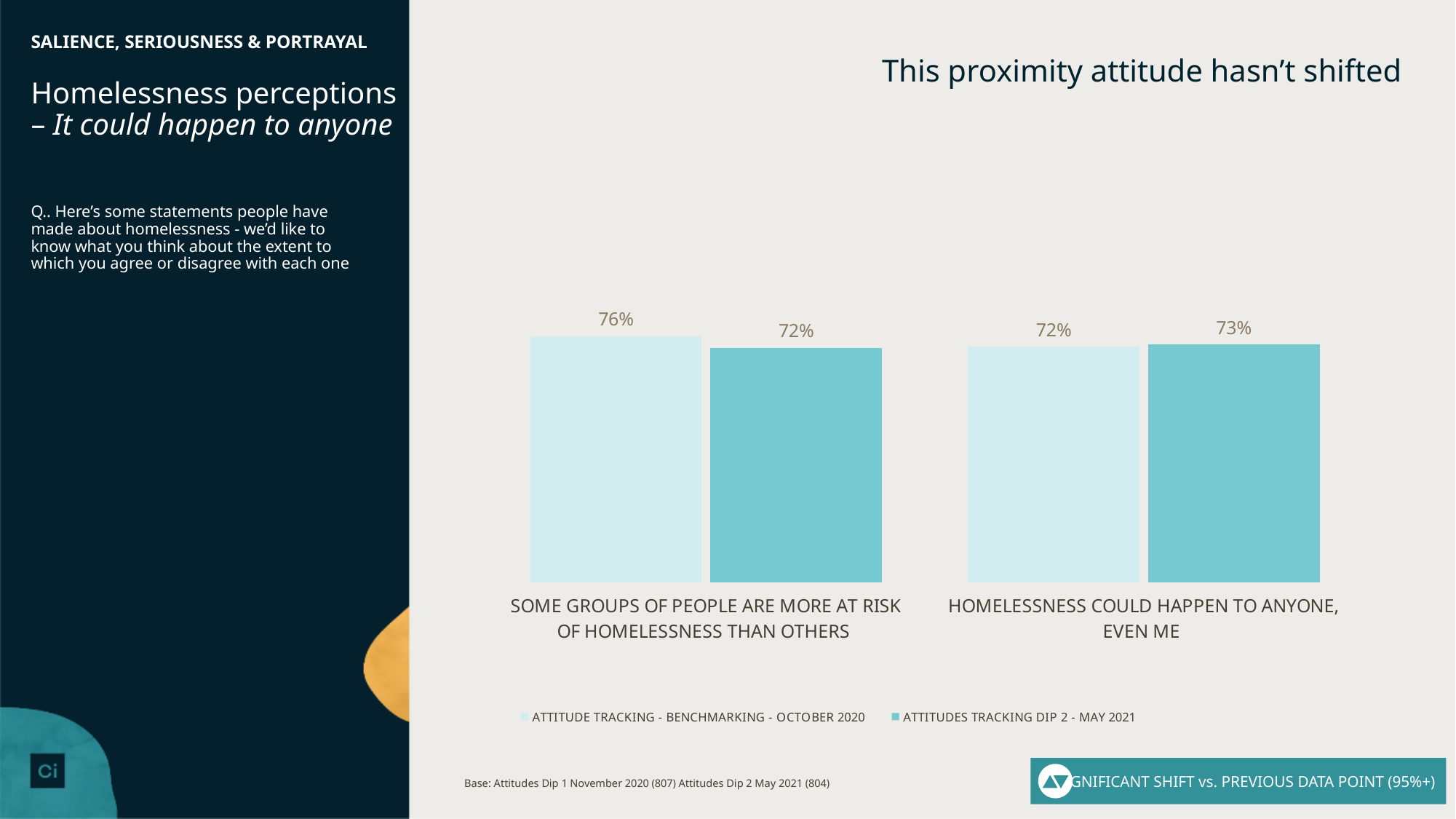
Which is larger for 'Some groups of people are more at risk of homelessness than others': the October 2020 value or the May 2021 value? October 2020 What is the title of the chart? This proximity attitude hasn't shifted What is the difference between the May 2021 and October 2020 values for 'Homelessness could happen to anyone, even me'? 1 percentage point What kind of chart is shown on the slide? Bar chart What is the value for 'Homelessness could happen to anyone, even me' in the Attitudes Tracking Dip 2 - May 2021 series? 73% What is the value for 'Homelessness could happen to anyone, even me' in the Attitude Tracking - Benchmarking - October 2020 series? 72% What is the value for 'Some groups of people are more at risk of homelessness than others' in the Attitude Tracking - Benchmarking - October 2020 series? 76% How many statement categories are shown on the chart? 2 What is the value for 'Some groups of people are more at risk of homelessness than others' in the Attitudes Tracking Dip 2 - May 2021 series? 72% How many series does the legend list? 2 Which bar has the highest value on the chart? Some groups of people are more at risk of homelessness than others, October 2020 (76%) What is the difference between the October 2020 and May 2021 values for 'Some groups of people are more at risk of homelessness than others'? 4 percentage points